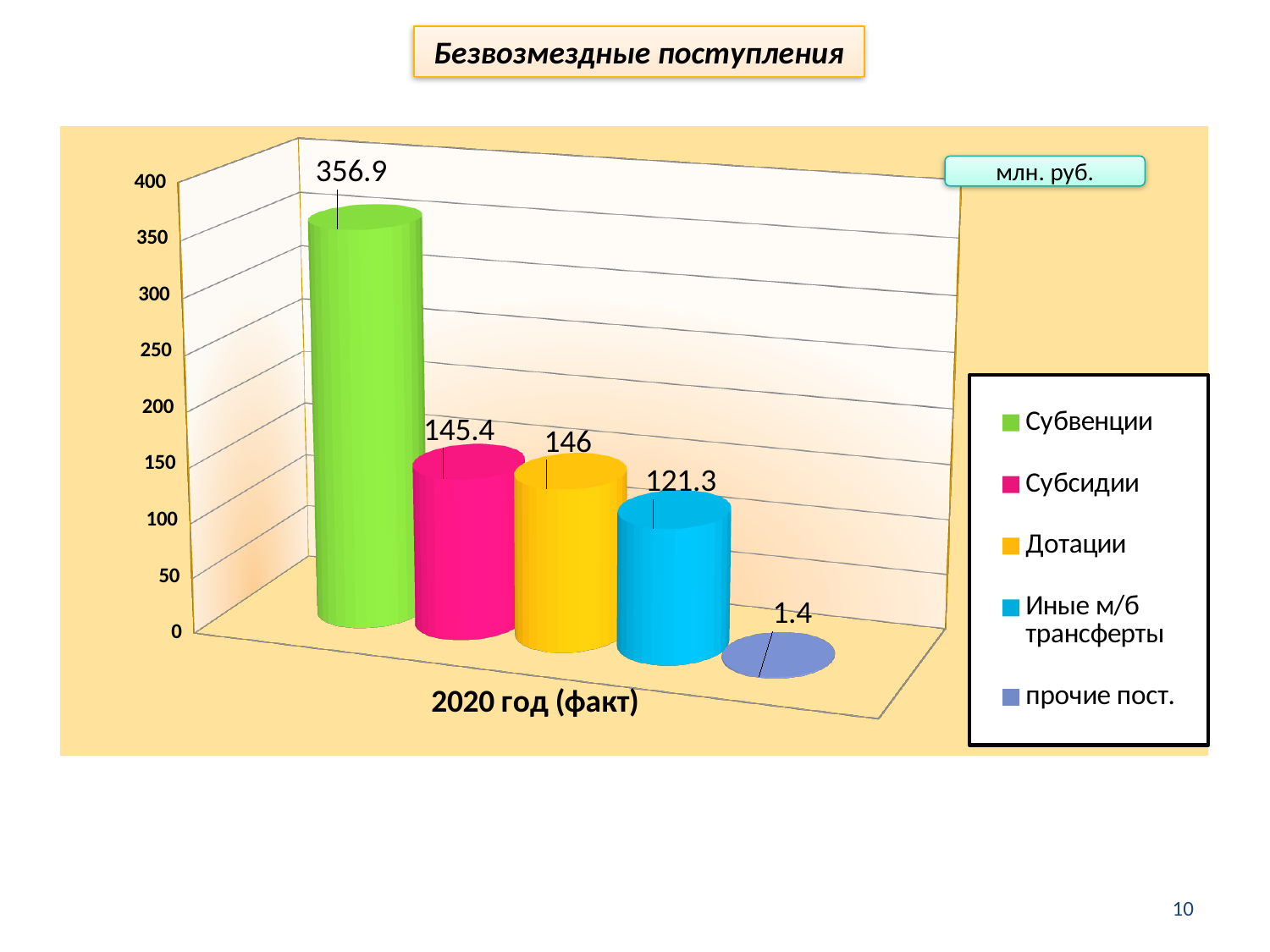
What kind of chart is shown on the slide? bar chart What is the value for прочие пост.? 1.4 Which is larger, the value for Дотации or the value for Субсидии? Дотации What is the value for Субвенции in 2020 год (факт)? 356.9 How many series does the legend list? 5 What is the difference between the values for Субвенции and Дотации? 210.9 Which series has the lowest value? прочие пост. What is the value for Субсидии? 145.4 What unit is shown in the box at the top right of the chart? млн. руб. Which series has the highest value? Субвенции What is the value for Иные м/б трансферты? 121.3 What is the value for Дотации? 146